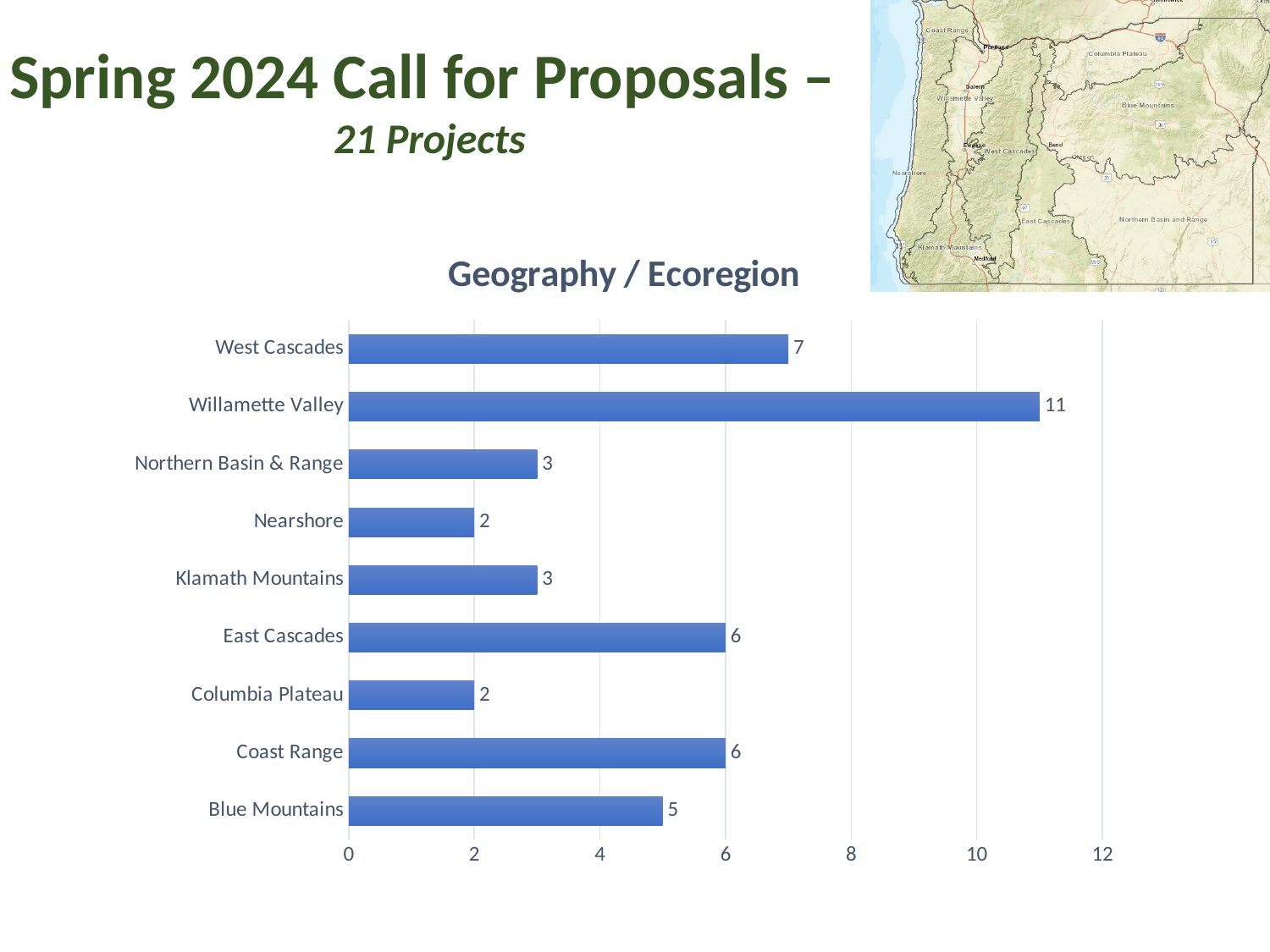
What is the value for West Cascades? 7 What is the title of the chart? Geography / Ecoregion How many categories are shown in the chart? 9 What is the difference between the values for Willamette Valley and West Cascades? 4 Which category has the highest value? Willamette Valley What kind of chart is shown on the slide? bar chart What is the value for Nearshore? 2 What is the value for Willamette Valley? 11 Which is larger, the value for East Cascades or the value for Blue Mountains? East Cascades What is the value for Blue Mountains? 5 Is the value for Willamette Valley greater or less than 10? greater What is the difference between the values for Coast Range and Columbia Plateau? 4